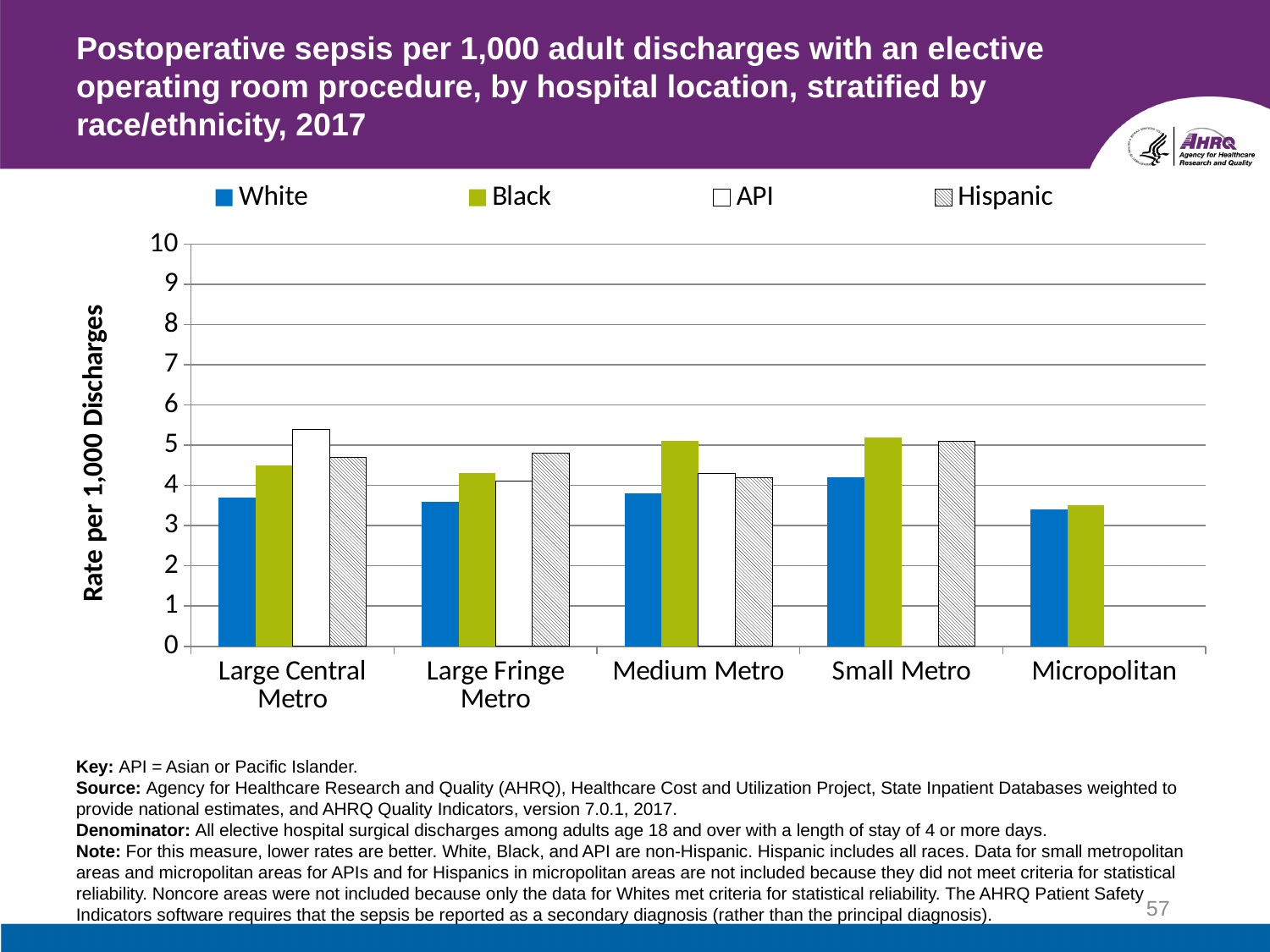
What kind of chart is shown on the slide? Bar chart Is the value for White in Large Central Metro greater or less than 4? less Is the value for Black in Small Metro greater or less than 5? greater Across the hospital locations, where is the White rate highest? Small Metro Within Large Central Metro, which race/ethnicity group has the highest rate? API How many hospital location categories are shown on the x axis? 5 Is the value for API in Large Central Metro greater or less than 5? greater What is the label on the y axis? Rate per 1,000 Discharges How many series does the legend list? 4 Which race/ethnicity groups have no bar shown for Micropolitan? API and Hispanic In Large Fringe Metro, which is larger, the value for Hispanic or the value for API? Hispanic In Medium Metro, which is larger, the value for Black or the value for White? Black